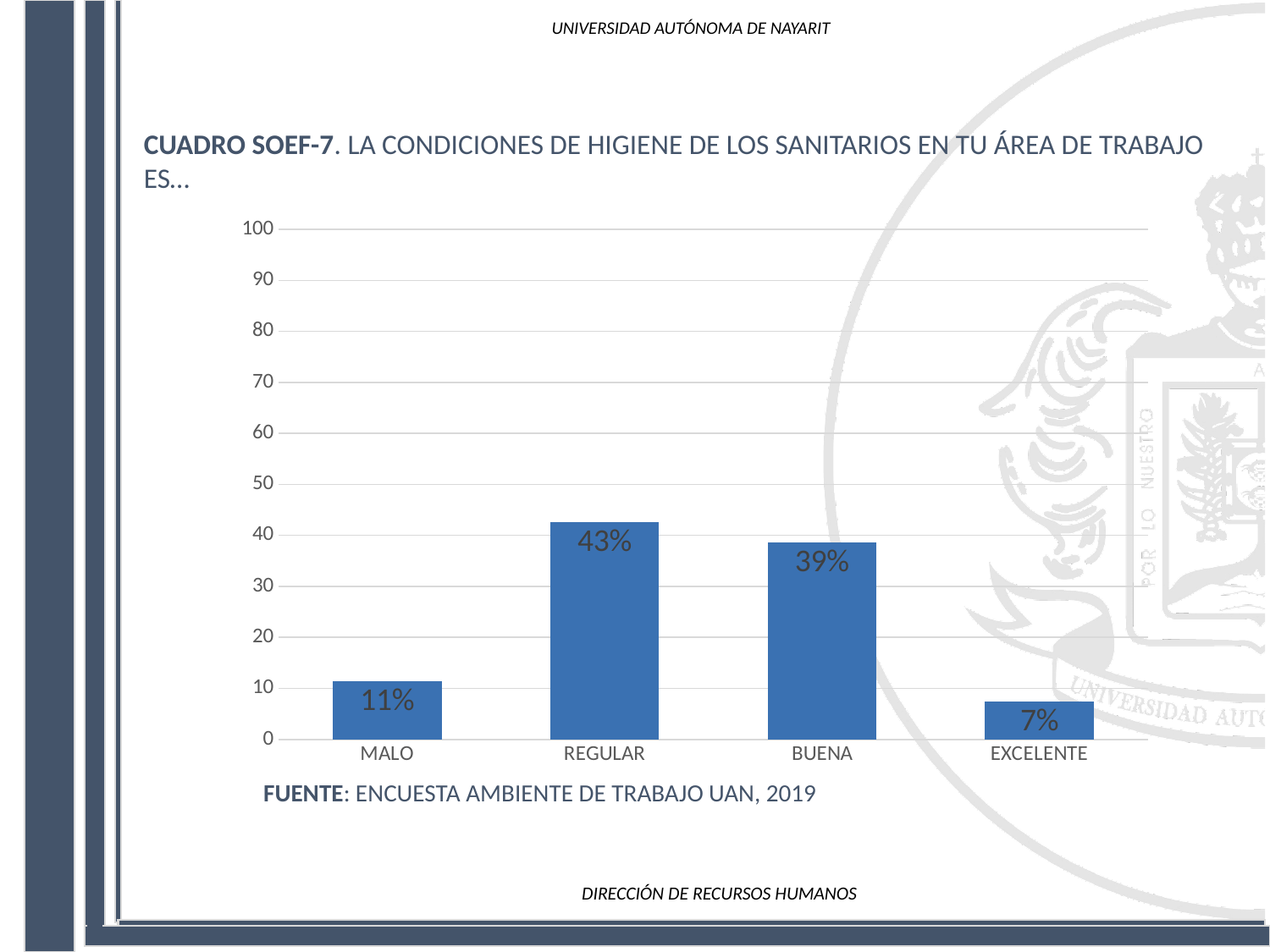
Is the value for BUENA greater or less than 30? greater What kind of chart is shown on the slide? bar chart What is the difference between the values for MALO and EXCELENTE? 4% How many categories are shown on the x axis? 4 What is the value for REGULAR? 43% What is the value for EXCELENTE? 7% Which category has the highest value? REGULAR What is the difference between the values for REGULAR and BUENA? 4% Which category has the lowest value? EXCELENTE What source is cited below the chart? ENCUESTA AMBIENTE DE TRABAJO UAN, 2019 Which is larger, the value for MALO or the value for EXCELENTE? MALO What is the value for MALO? 11%